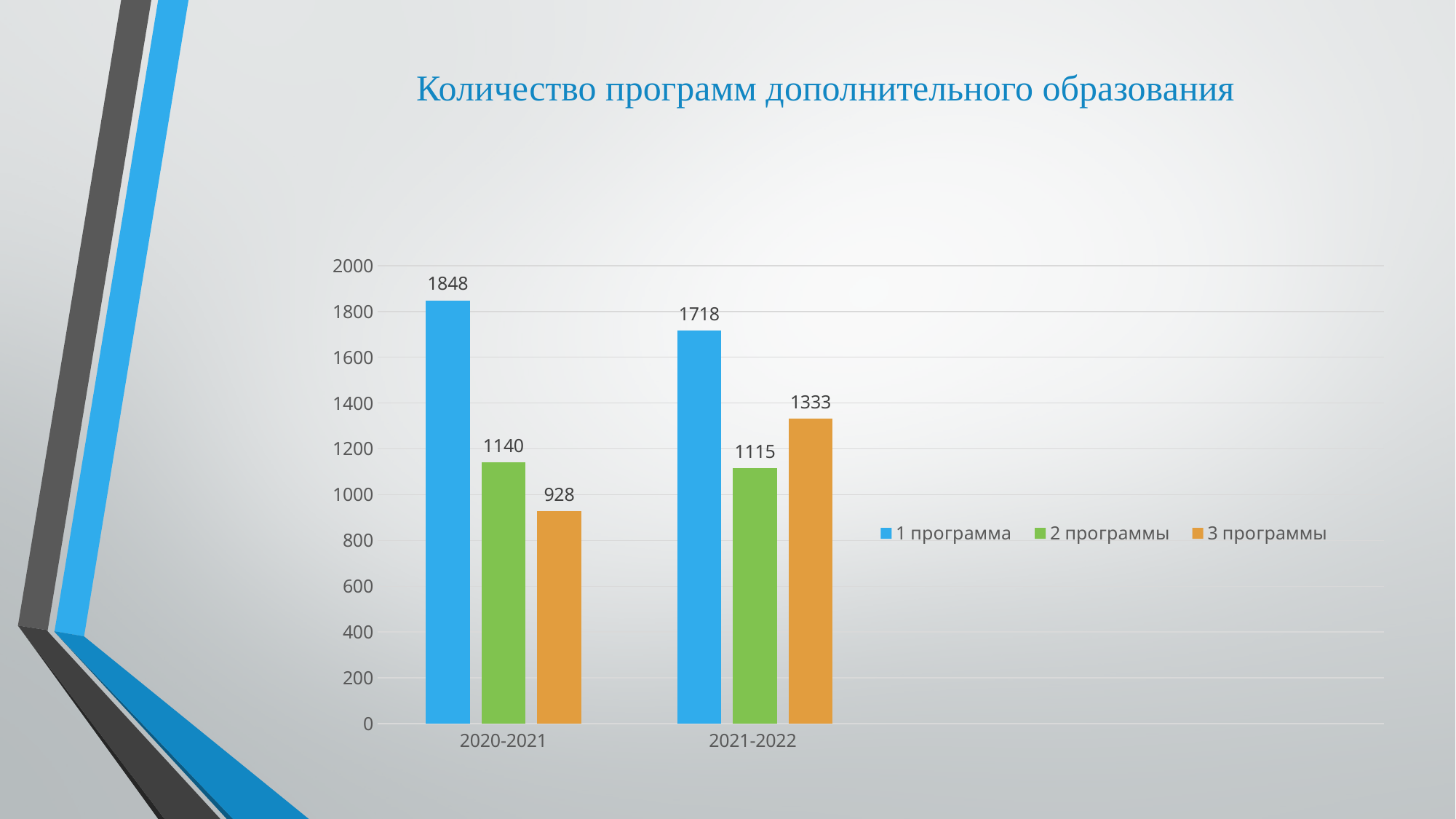
Which series has the highest value in 2021-2022? 1 программа What is the value for "1 программа" in 2020-2021? 1848 What kind of chart is shown on the slide? bar chart What is the difference between "3 программы" in 2021-2022 and in 2020-2021? 405 Which series has the lowest value in 2020-2021? 3 программы What is the value for "2 программы" in 2021-2022? 1115 What is the value for "3 программы" in 2021-2022? 1333 What is the title of the chart? Количество программ дополнительного образования Which is larger: "2 программы" in 2020-2021 or "2 программы" in 2021-2022? 2020-2021 How many series does the legend list? 3 What is the difference between the "1 программа" values for 2020-2021 and 2021-2022? 130 How many categories are shown on the x axis? 2